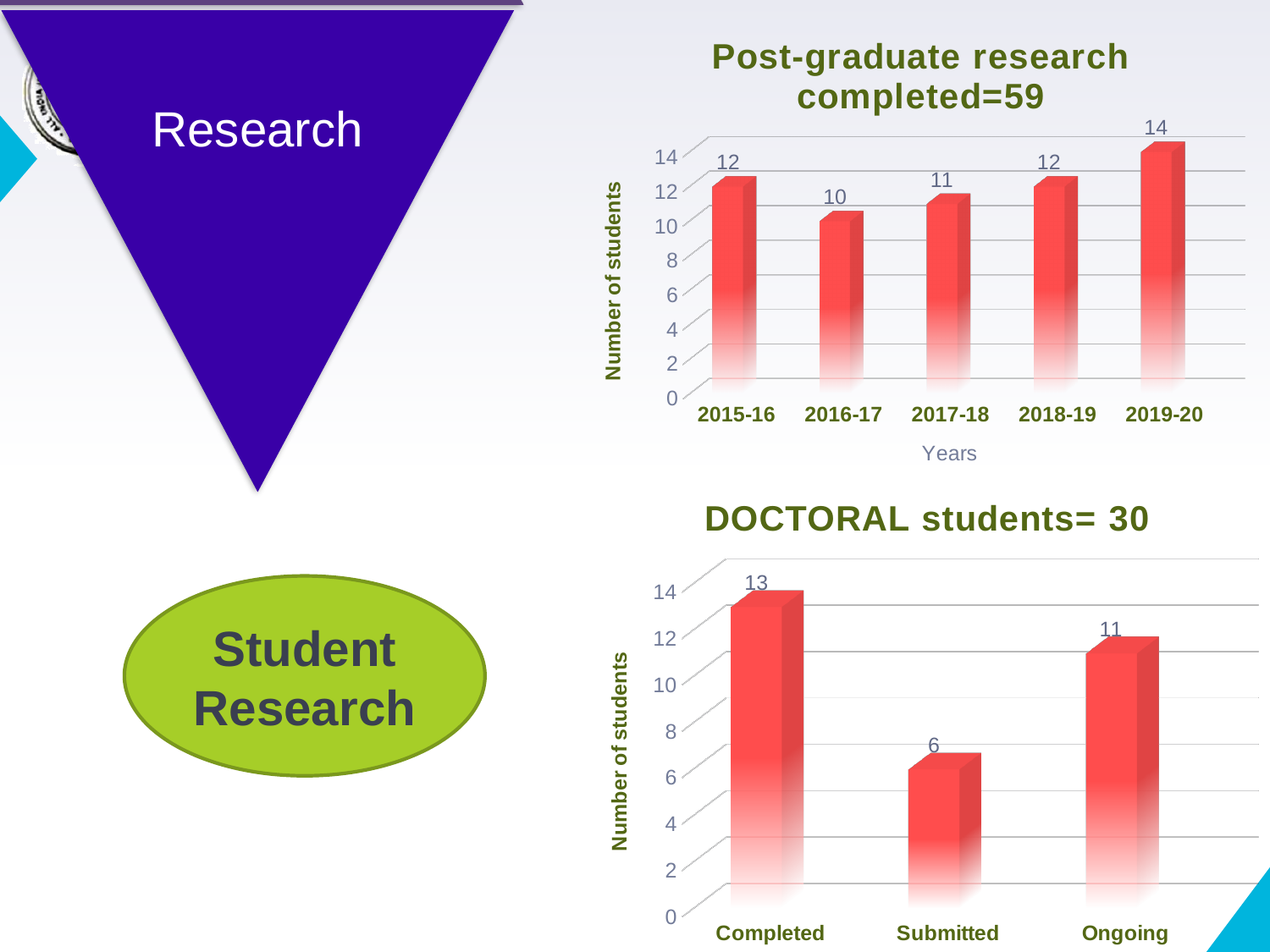
In the 'Post-graduate research completed=59' chart, what is the value for 2017-18? 11 In the 'Post-graduate research completed=59' chart, what is the difference between the values for 2019-20 and 2016-17? 4 In the 'DOCTORAL students= 30' chart, what is the value for Submitted? 6 In the 'DOCTORAL students= 30' chart, what is the difference between the values for Completed and Submitted? 7 In the 'DOCTORAL students= 30' chart, which is larger, the value for Completed or the value for Ongoing? Completed In the 'DOCTORAL students= 30' chart, which category has the highest value? Completed In the 'Post-graduate research completed=59' chart, what is the label of the y axis? Number of students In the 'DOCTORAL students= 30' chart, which category has the lowest value? Submitted In the 'Post-graduate research completed=59' chart, how many years are shown on the x axis? 5 What kind of chart is the 'DOCTORAL students= 30' chart? Bar chart In the 'Post-graduate research completed=59' chart, which year has the highest number of students? 2019-20 In the 'Post-graduate research completed=59' chart, which year has the lowest number of students? 2016-17